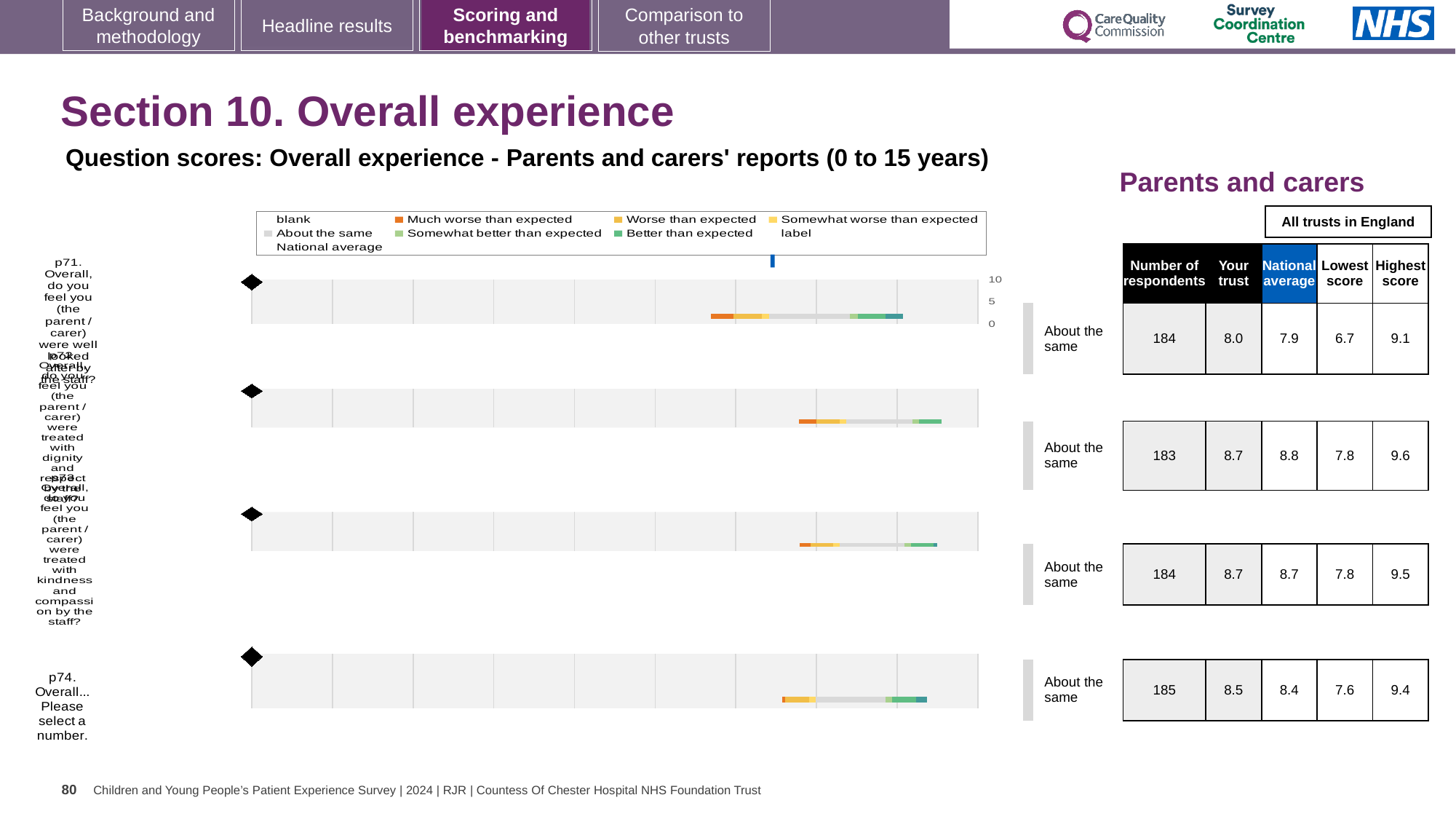
In the table beside the chart, what is the 'Your trust' score for p74 (Overall... Please select a number)? 8.5 Which question row has the lowest 'Your trust' score in the table? p71 For p71, which is larger: the 'Your trust' score or the 'National average'? Your trust How many entries does the chart legend list? 9 What kind of chart is shown on the slide? bar chart How many question rows (bars) are plotted in the chart? 4 What is the 'National average' score for p74 in the table? 8.4 In the table beside the chart, how many respondents are listed for p71? 184 What colour represents 'Much worse than expected' in the chart legend? orange For p74, what is the difference between the highest score and the lowest score in the table? 1.8 What benchmark category label is shown beside each bar in the chart? About the same